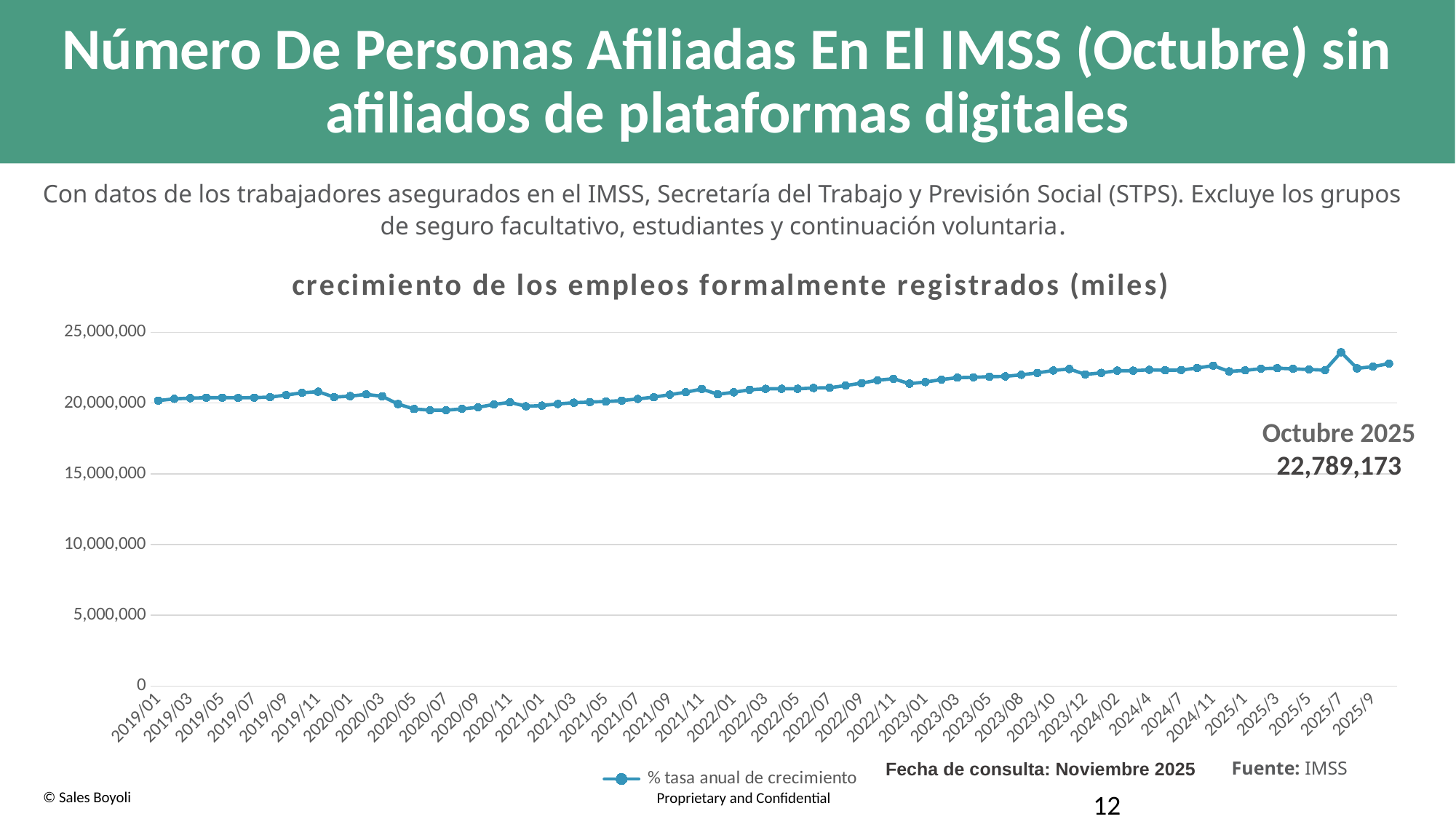
Which x-axis period has the highest value on the chart? 2025/7 What value is annotated for Octubre 2025 on the chart? 22,789,173 How many series does the chart legend list? 1 Is the value for 2025/7 greater or less than 20,000,000? greater Which is larger, the value for 2025/7 or the value for 2019/01? 2025/7 Is the value for 2020/07 greater or less than 20,000,000? less What kind of chart is shown on the slide? Line chart Which x-axis period has the lowest value on the chart? 2020/07 Overall, do the values rise or fall from 2019/01 to 2025/9? rise Is the value for 2019/01 greater or less than 25,000,000? less What is the title of the chart? crecimiento de los empleos formalmente registrados (miles) What is the legend entry for the plotted series? % tasa anual de crecimiento